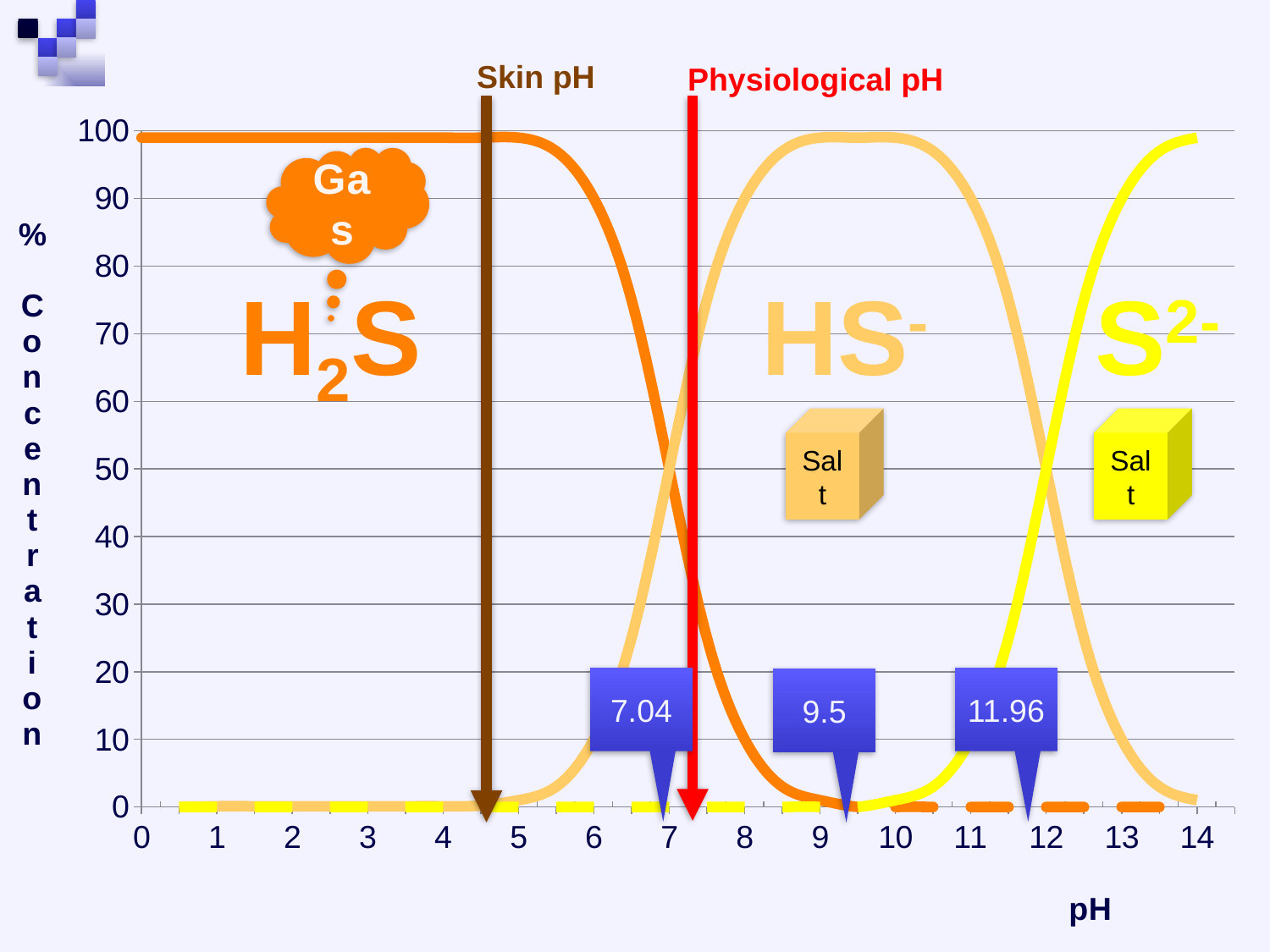
What is the label of the y axis? % Concentration Is the % concentration of H2S at pH 2 greater or less than 90? greater Is the % concentration of HS- at pH 9 greater or less than 90? greater What pH value is shown in the middle callout box near the bottom of the chart? 9.5 Which species has the higher % concentration at pH 13, HS- or S2-? S2- What kind of chart is shown on the slide? line chart What pH value is shown in the rightmost callout box near the bottom of the chart? 11.96 Does the H2S curve rise or fall as pH increases from 5 to 9? fall How many species curves are plotted on the chart? 3 What is the label of the x axis? pH Is the % concentration of S2- at pH 10 greater or less than 10? less What pH value is shown in the first (leftmost) callout box near the bottom of the chart? 7.04